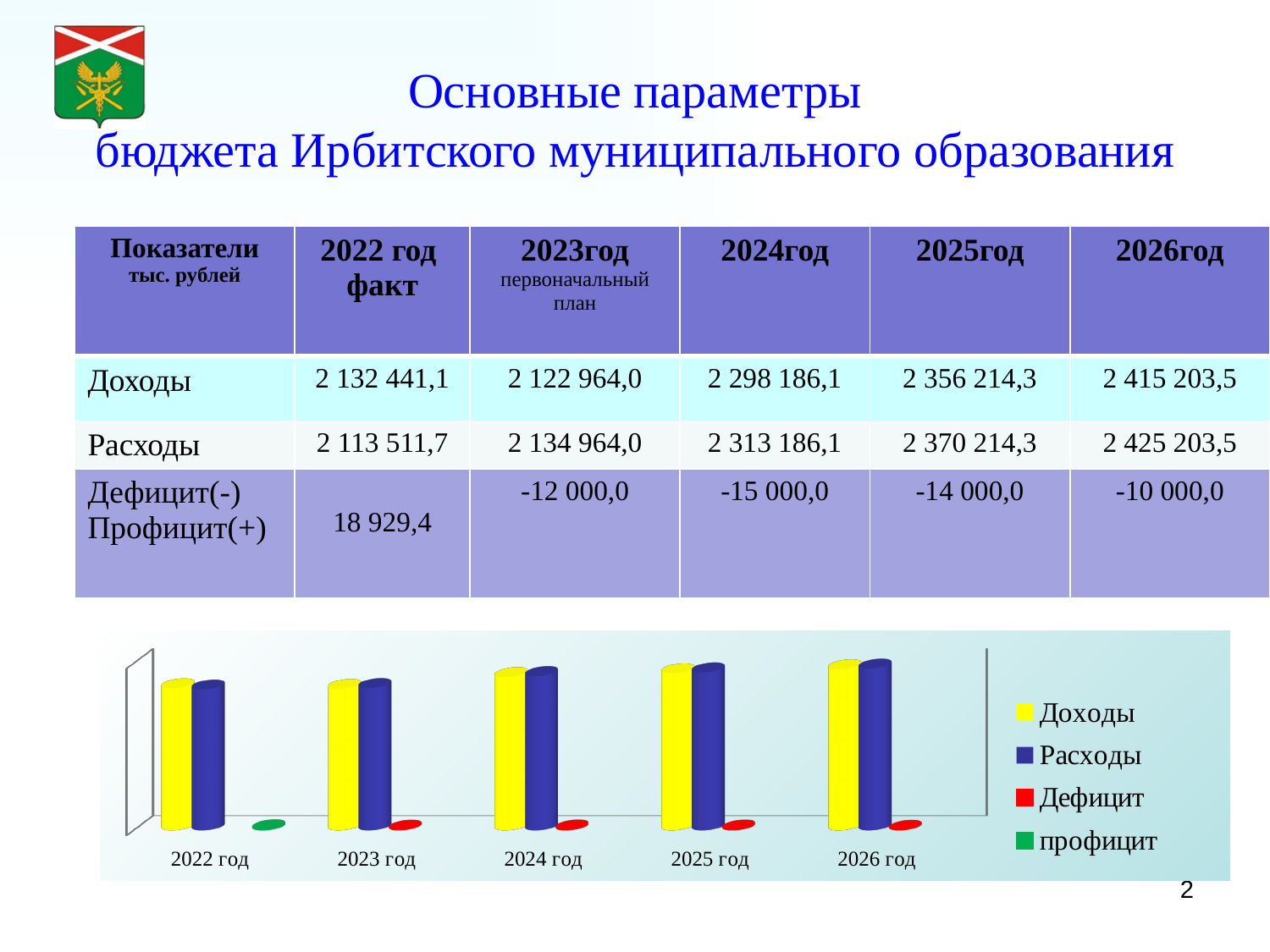
How many year categories are shown along the x axis of the chart? 5 What kind of chart is shown at the bottom of the slide? bar chart According to the table on the slide, what is the value of Доходы for 2024 год? 2 298 186,1 According to the table on the slide, what is the Дефицит(-)/Профицит(+) value for 2022 год? 18 929,4 Do the Доходы bars generally rise or fall from 2022 год to 2026 год? rise How many series does the chart legend list? 4 For which year does the chart show a green профицит marker instead of a red Дефицит marker? 2022 год In the chart, is the Доходы bar for 2026 год taller or shorter than the Доходы bar for 2022 год? taller What are the entries in the chart legend? Доходы, Расходы, Дефицит, профицит Which colour represents Доходы in the chart? yellow According to the table on the slide, what is the value of Расходы for 2026 год? 2 425 203,5 In the chart, which is larger for 2024 год: Расходы or Дефицит? Расходы